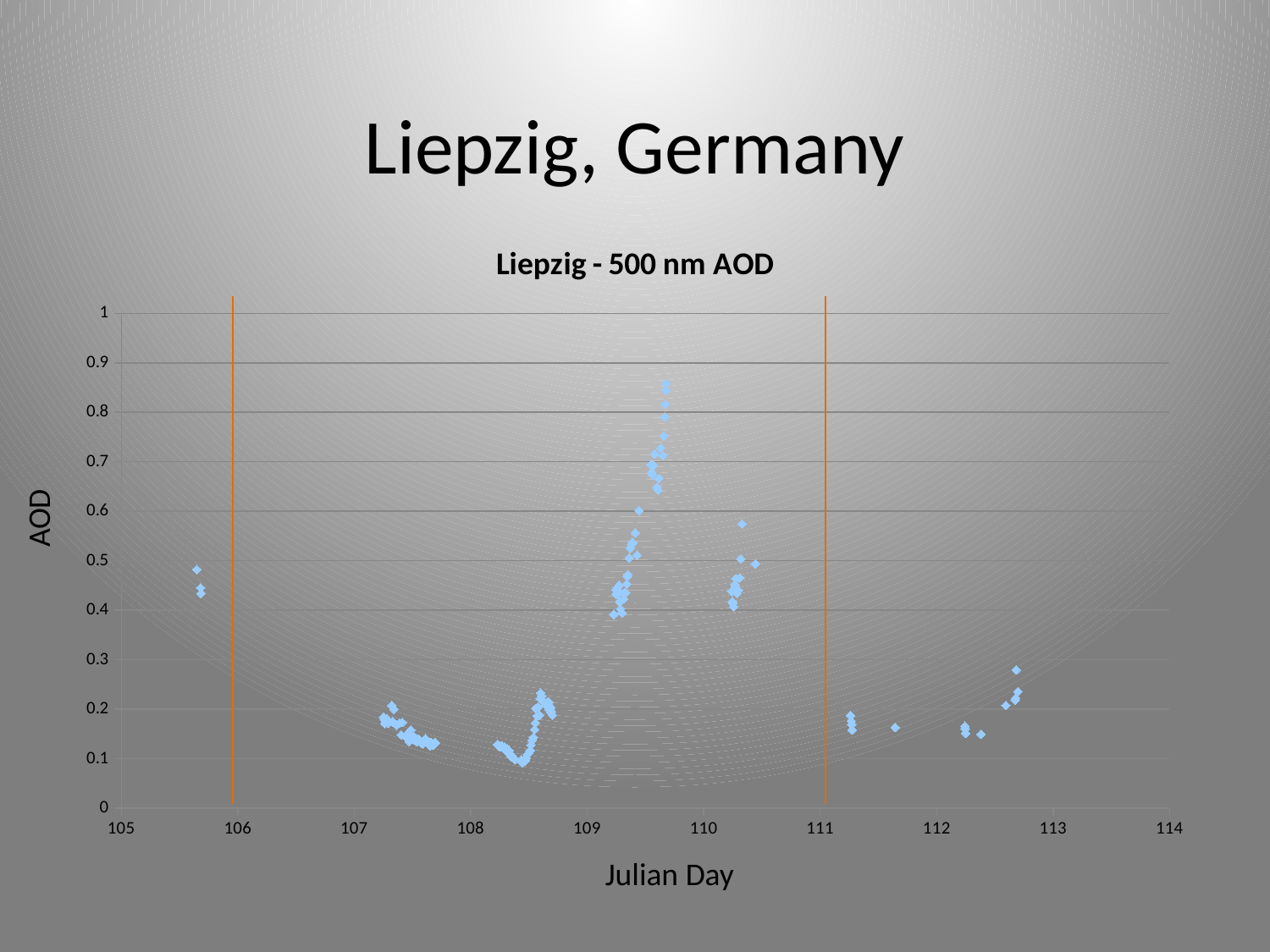
Are the AOD values plotted between Julian day 111 and 112 greater or less than 0.2? less Are the AOD values plotted between Julian day 107 and 108 greater or less than 0.3? less Are the AOD values plotted between Julian day 112 and 113 greater or less than 0.4? less What kind of chart is shown on the slide? scatter chart Between which two x-axis ticks does the highest AOD value on the chart fall? 109 and 110 How many orange vertical lines are drawn on the chart? 2 Which group of points has higher AOD values: those between Julian day 109 and 110, or those between Julian day 107 and 108? those between Julian day 109 and 110 What is the title of the chart? Liepzig - 500 nm AOD What is the maximum value shown on the AOD (y) axis? 1